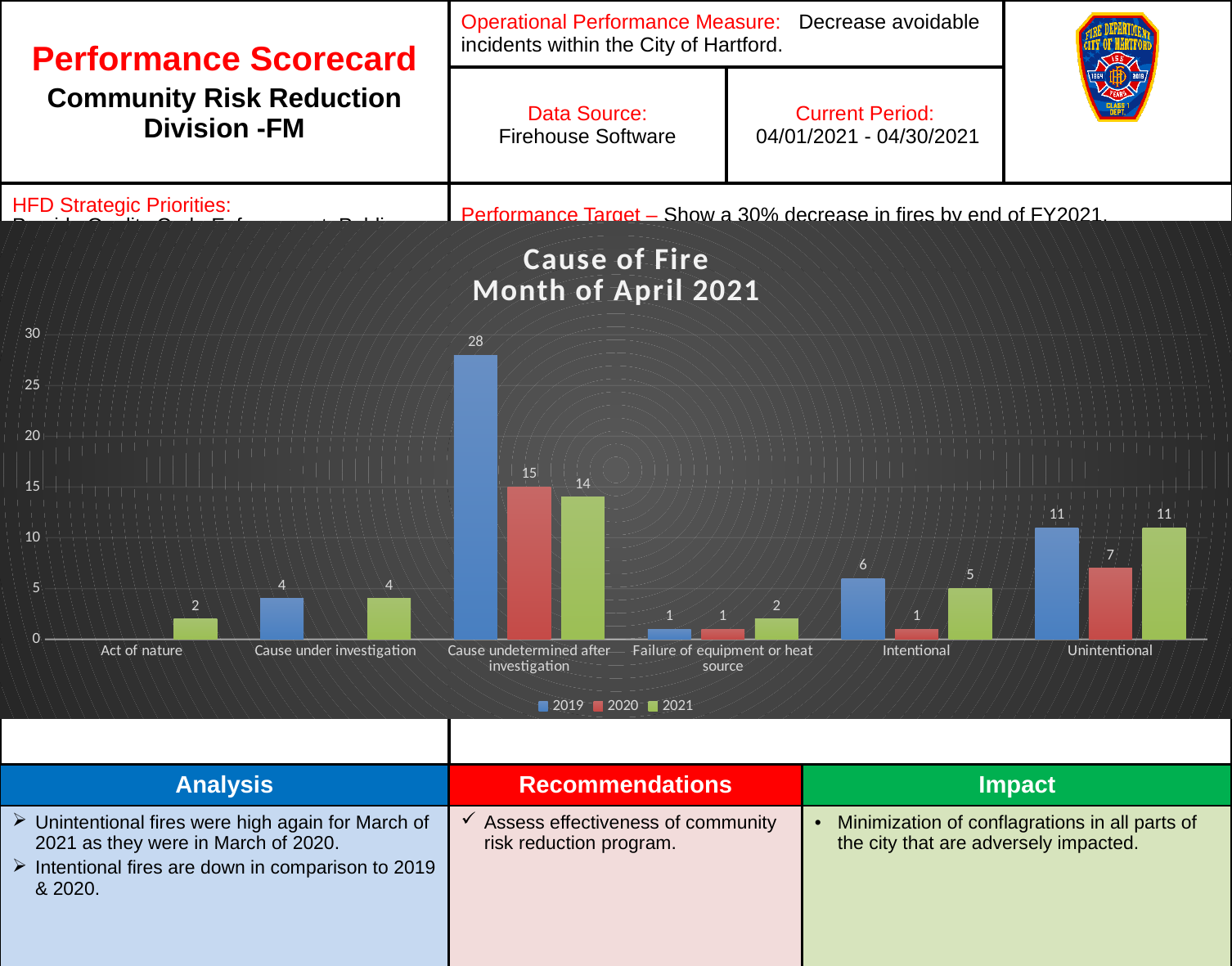
How many series does the chart legend list? 3 What is the 2019 value for Cause undetermined after investigation? 28 Is the 2019 value for Cause undetermined after investigation greater or less than 25? greater What is the 2021 value for Intentional fires? 5 How many cause categories are shown on the x axis of the chart? 6 What is the 2020 value for Unintentional fires? 7 Which is larger for Intentional fires, the 2019 value or the 2020 value? 2019 What is the title of the chart? Cause of Fire Month of April 2021 What type of chart is shown on the slide? bar chart Which category has the highest 2019 value? Cause undetermined after investigation What is the difference between the 2019 and 2021 values for Cause undetermined after investigation? 14 Which series is shown in green in the chart? 2021